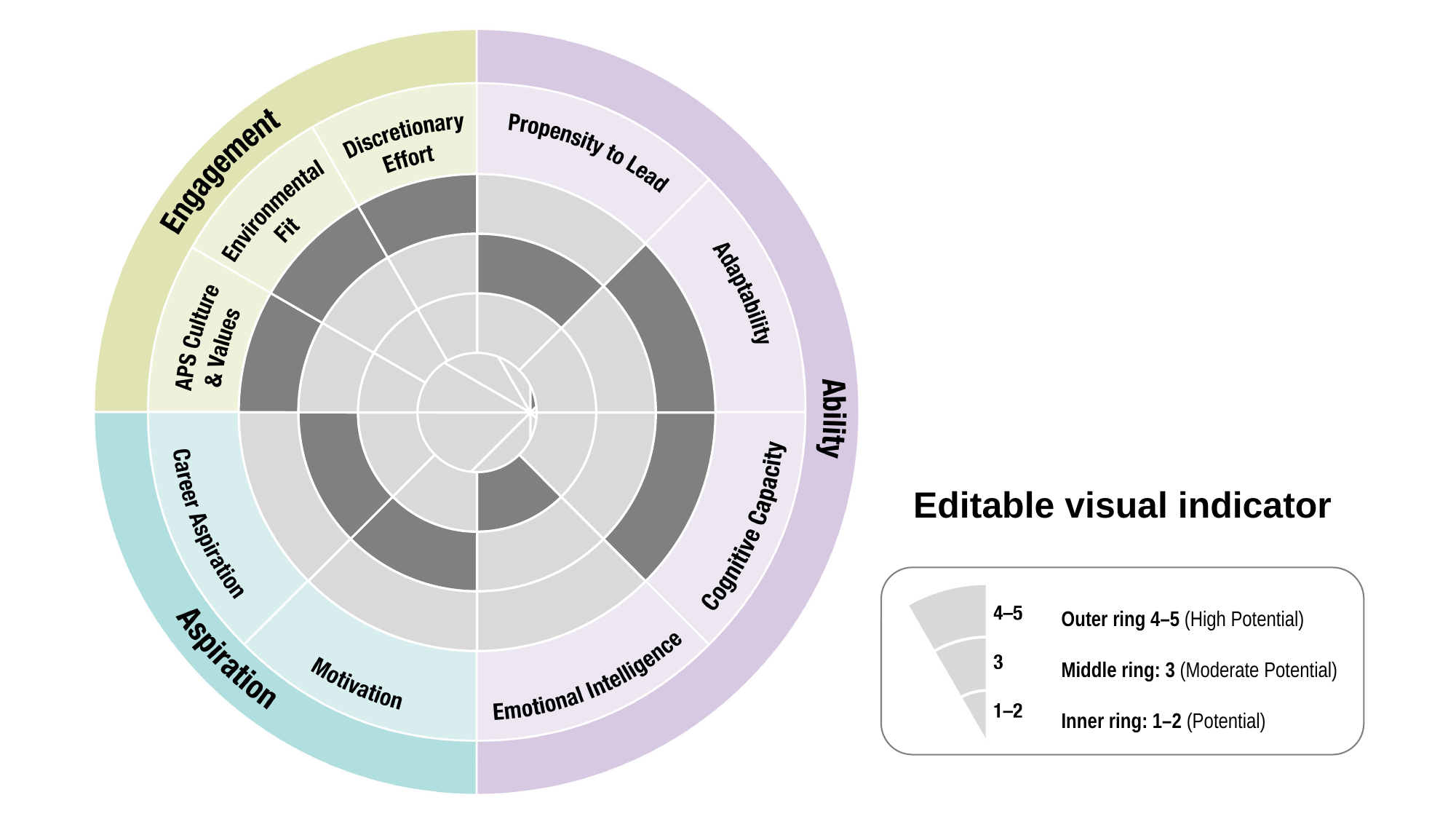
Which ring is shaded dark for Motivation? Middle ring (3) Which sub-dimension is the only one shaded at the inner ring (1–2) level? Emotional Intelligence Which ring is shaded dark for Adaptability? Outer ring (4–5) How many ring levels does the legend list? 3 How many sub-dimensions are labelled around the ring of the visual indicator? 9 Which ring is shaded dark for Propensity to Lead? Middle ring (3) Which is rated higher on the indicator, Adaptability or Emotional Intelligence? Adaptability According to the legend, what does the middle ring represent? 3 (Moderate Potential) Which domain does Motivation belong to? Aspiration Which ring is shaded dark for Cognitive Capacity? Outer ring (4–5) Which ring is shaded dark for Emotional Intelligence? Inner ring (1–2) How many main domains are shown on the outermost coloured ring? 3